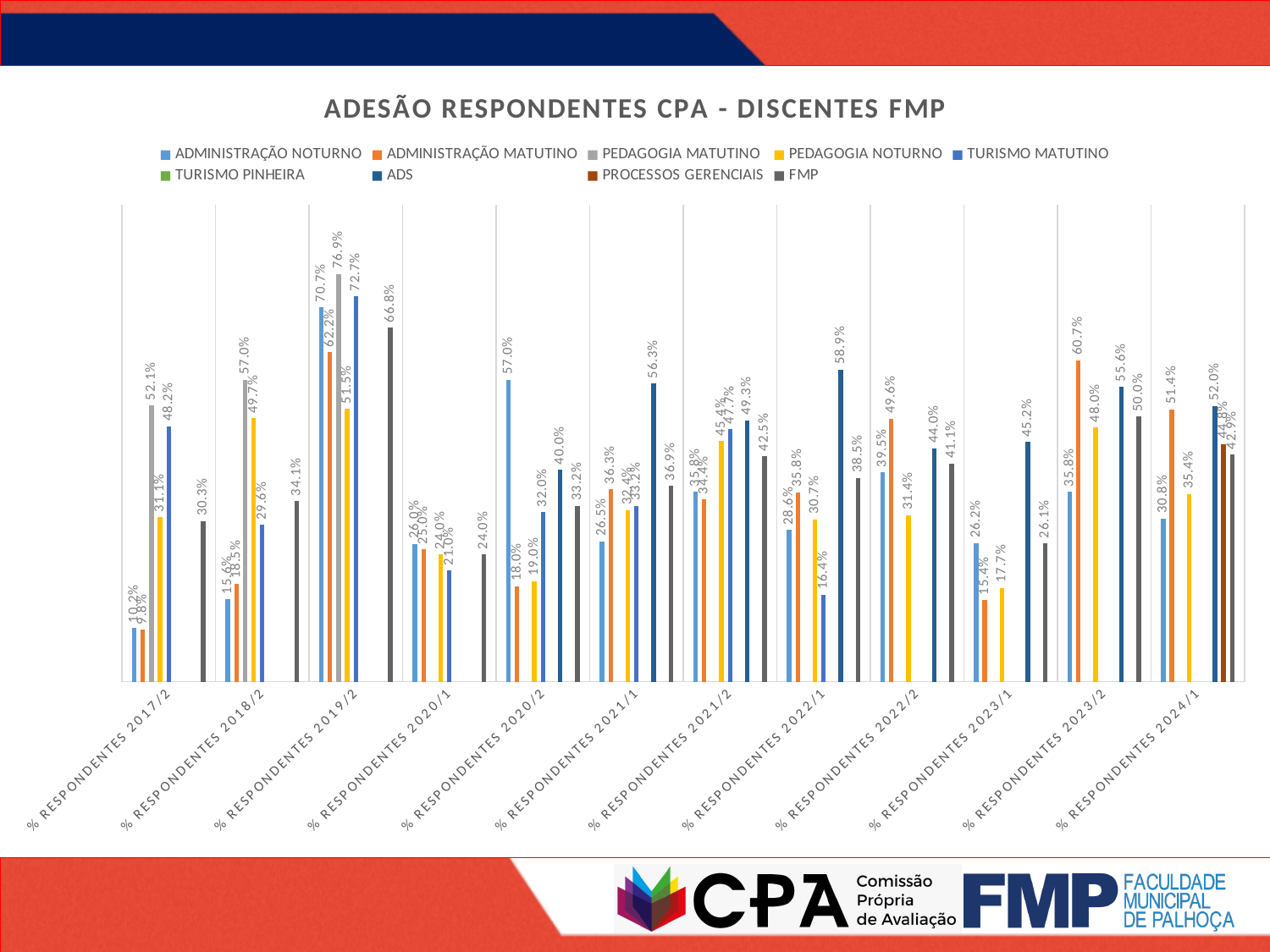
How many series does the legend list? 9 Which series has the lowest value in % RESPONDENTES 2017/2? ADMINISTRAÇÃO MATUTINO What is the PEDAGOGIA NOTURNO value for % RESPONDENTES 2018/2? 49.7% What is the FMP value for % RESPONDENTES 2019/2? 66.8% What is the ADS value for % RESPONDENTES 2022/1? 58.9% Which series has the highest value in % RESPONDENTES 2019/2? PEDAGOGIA MATUTINO What is the FMP value for % RESPONDENTES 2023/2? 50.0% In % RESPONDENTES 2023/2, what is the difference between ADMINISTRAÇÃO MATUTINO and ADMINISTRAÇÃO NOTURNO? 24.9 percentage points How many categories (periods) are shown on the x axis? 12 What is the title of the chart? ADESÃO RESPONDENTES CPA - DISCENTES FMP In % RESPONDENTES 2020/2, which is larger: ADMINISTRAÇÃO NOTURNO or ADS? ADMINISTRAÇÃO NOTURNO What kind of chart is shown on the slide? Bar chart